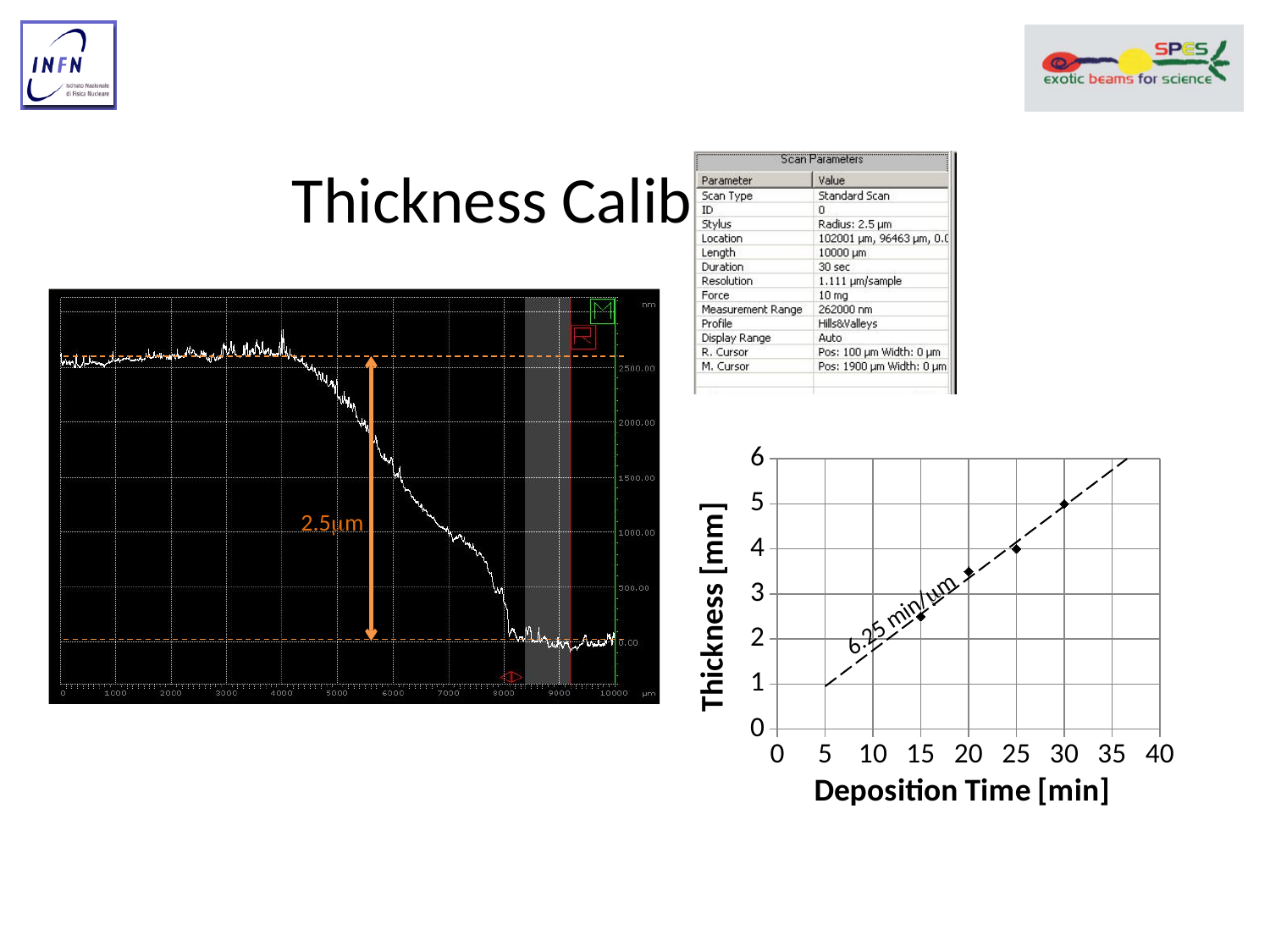
On the Thickness vs Deposition Time chart, which deposition time has the lowest thickness? 15 min On the Thickness vs Deposition Time chart, what is the thickness at a deposition time of 30 min? 5 On the Thickness vs Deposition Time chart, does thickness rise or fall as deposition time increases? rise On the Thickness vs Deposition Time chart, which has the larger thickness: 20 min or 30 min? 30 min On the Thickness vs Deposition Time chart, is the thickness at 20 min greater or less than 3? greater On the Thickness vs Deposition Time chart, which deposition time has the highest thickness? 30 min What step height is annotated by the orange arrow on the profilometer chart on the left of the slide? 2.5µm What kind of chart is the Thickness vs Deposition Time chart on the right of the slide? scatter chart On the Thickness vs Deposition Time chart, is the thickness at 15 min greater or less than 3? less On the Thickness vs Deposition Time chart, what is the thickness at a deposition time of 25 min? 4 How many data points are plotted on the Thickness vs Deposition Time chart? 4 What slope is written along the dashed line on the Thickness vs Deposition Time chart? 6.25 min/µm